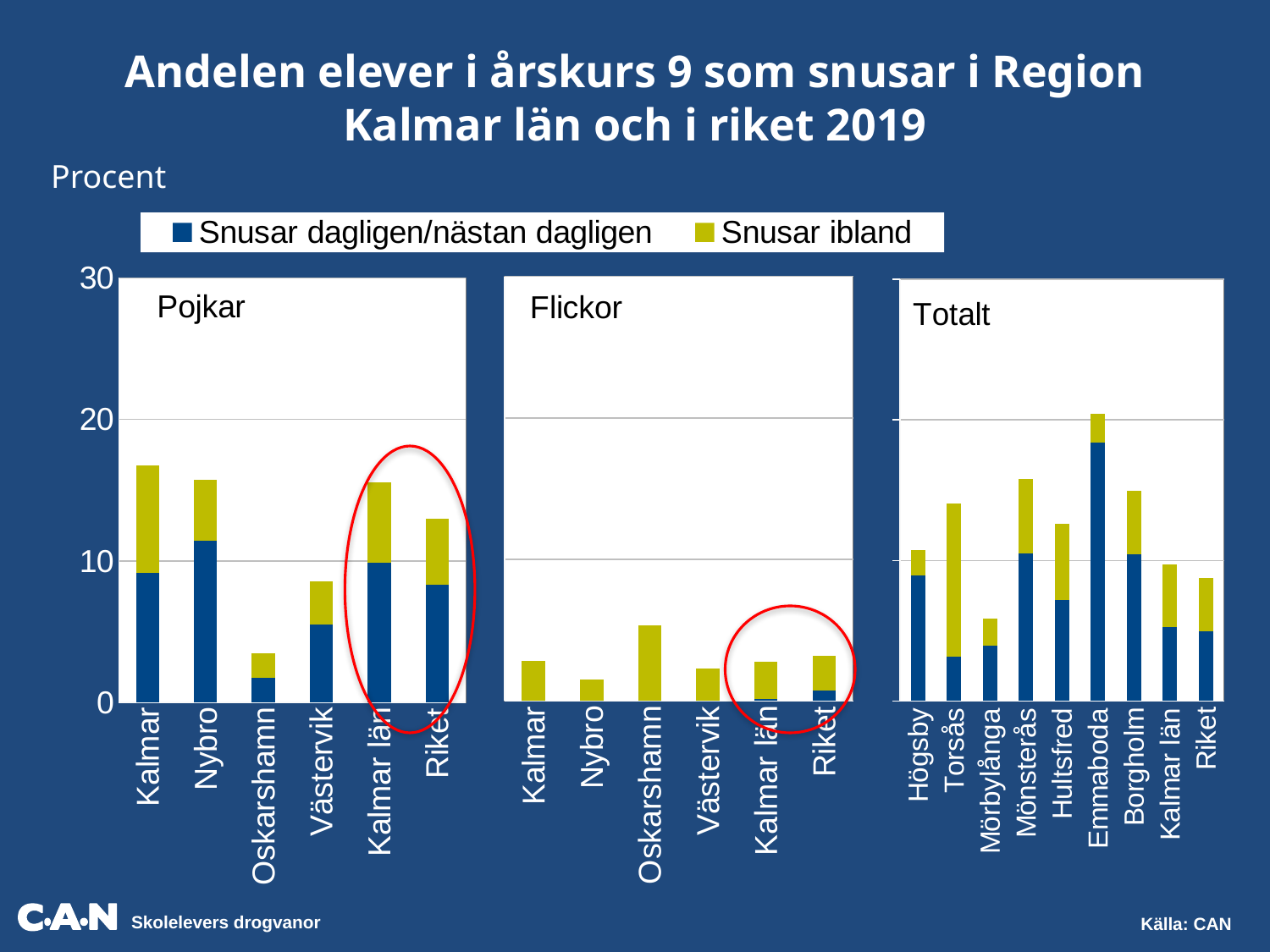
In the Totalt panel, which category has the highest total bar? Emmaboda What are the two series named in the legend? Snusar dagligen/nästan dagligen; Snusar ibland In the Pojkar panel, is the total value for Riket greater or less than 10? greater In the Totalt panel, which category has the lowest total bar? Mörbylånga In the Totalt panel, is the total value for Mörbylånga greater or less than 10? less In the Pojkar panel, which category has the lowest total bar? Oskarshamn In the Pojkar panel, how many categories are shown on the x axis? 6 In the Totalt panel, which has the larger total bar, Mönsterås or Hultsfred? Mönsterås In the Flickor panel, which category has the highest total bar? Oskarshamn In the Totalt panel, how many categories are shown on the x axis? 9 How many series does the legend list? 2 What kind of chart is shown on the slide? Stacked bar chart